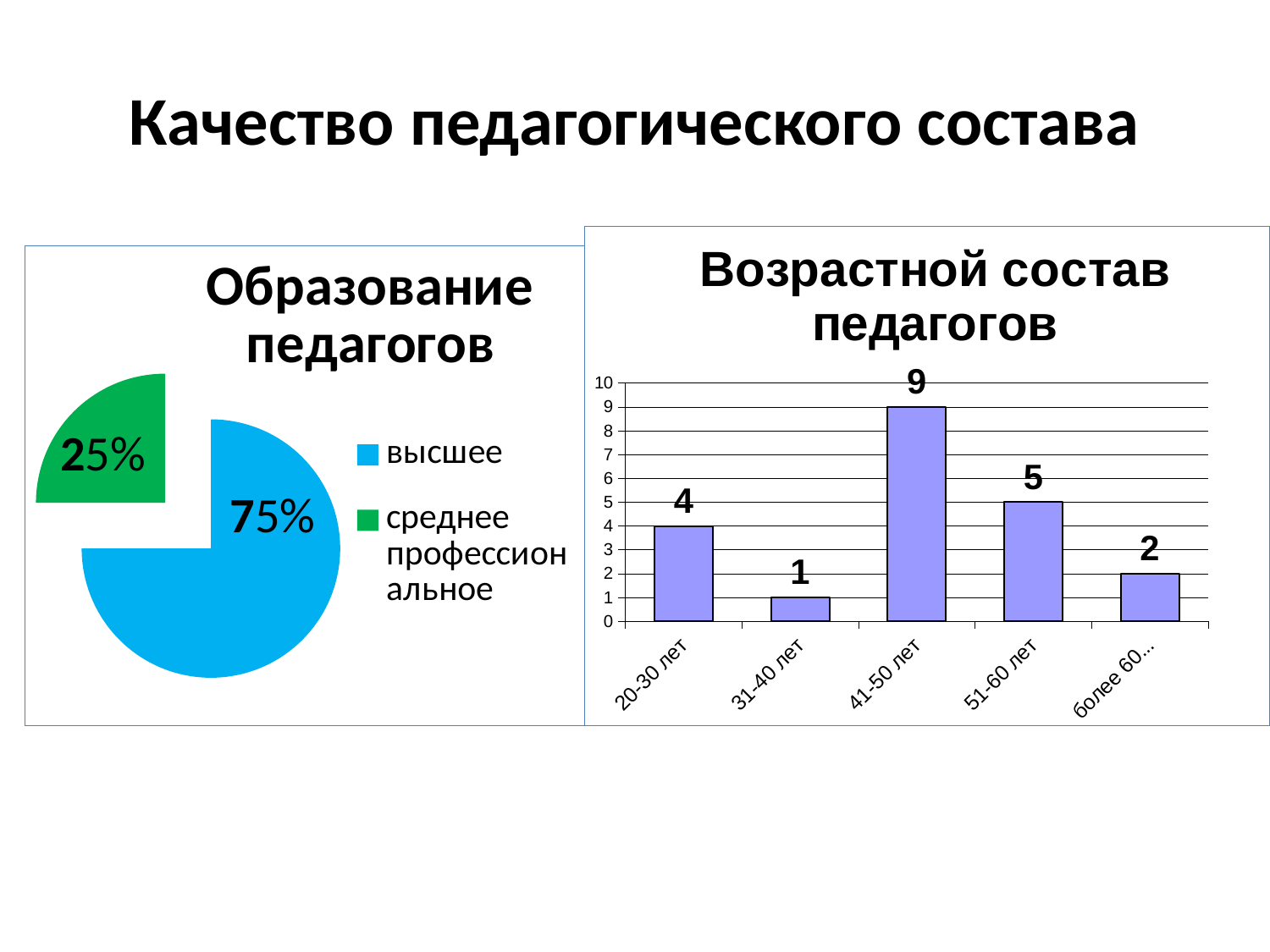
In the 'Возрастной состав педагогов' chart, which age group has the lowest value? 31-40 лет In the 'Возрастной состав педагогов' chart, what is the value for '20-30 лет'? 4 In the 'Образование педагогов' chart, what share of the pie is 'высшее'? 75% How many slices does the 'Образование педагогов' pie chart have? 2 In the 'Возрастной состав педагогов' chart, what is the difference between the values for '41-50 лет' and '51-60 лет'? 4 What kind of chart is 'Возрастной состав педагогов'? bar chart What kind of chart is 'Образование педагогов'? pie chart In the 'Образование педагогов' chart, which slice is larger, 'высшее' or 'среднее профессиональное'? высшее In the 'Возрастной состав педагогов' chart, what is the value for '41-50 лет'? 9 In the 'Образование педагогов' chart, what share of the pie is 'среднее профессиональное'? 25% In the 'Возрастной состав педагогов' chart, which age group has the highest value? 41-50 лет How many bars are in the 'Возрастной состав педагогов' chart? 5